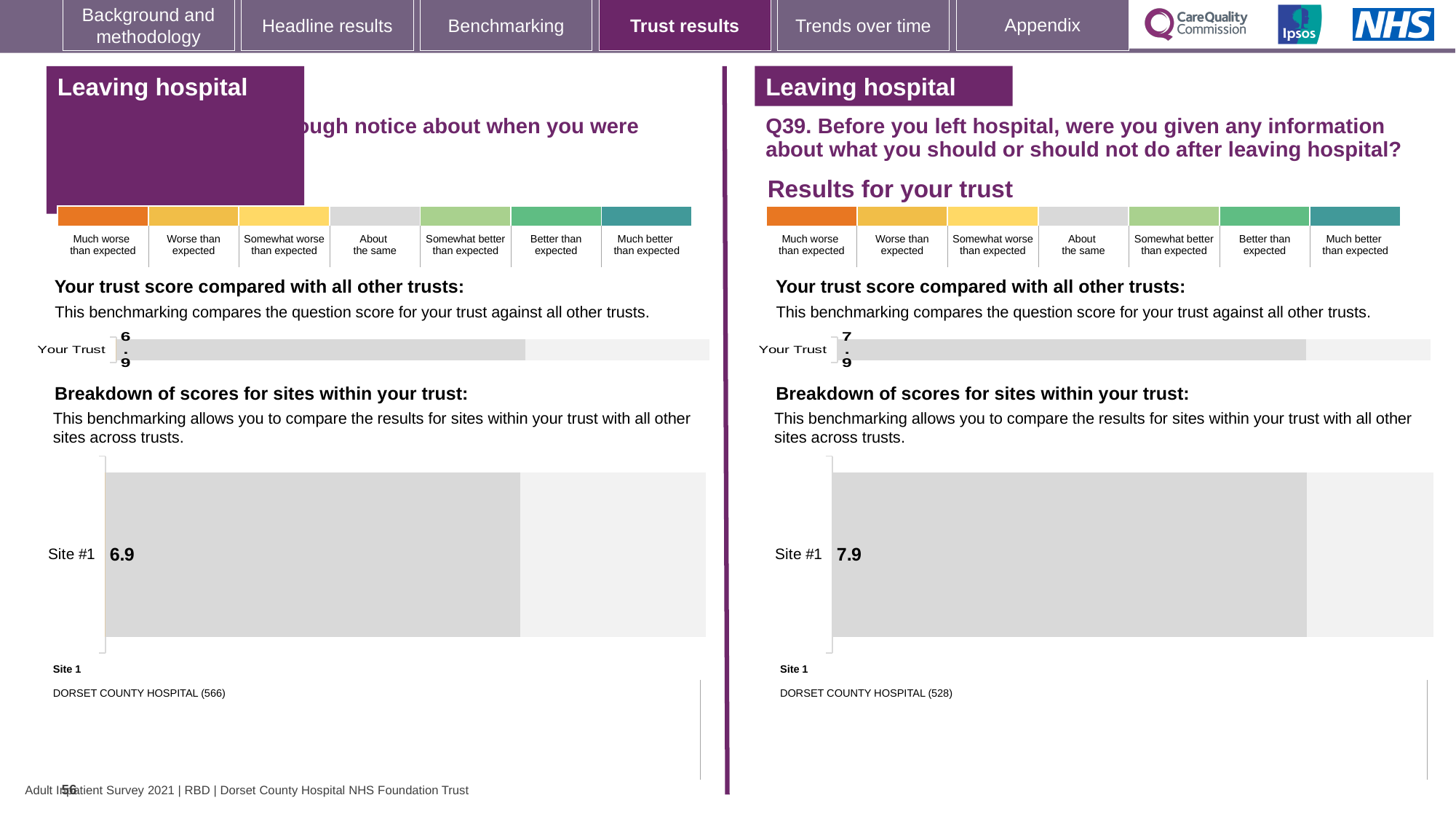
On the left-hand side of the slide, which site name is listed as Site 1 below the chart? DORSET COUNTY HOSPITAL (566) On the left-hand side of the slide, what is the score shown for Your Trust in the 'Your trust score compared with all other trusts' chart? 6.9 On the right-hand side of the slide (Q39), which site name is listed as Site 1 below the chart? DORSET COUNTY HOSPITAL (528) What type of chart is used to show the Site #1 score on the right-hand side of the slide (Q39)? bar chart On the left-hand side of the slide, what score is shown for Site #1 in the 'Breakdown of scores for sites within your trust' chart? 6.9 Which is larger: the Site #1 score on the left-hand side of the slide or the Site #1 score on the right-hand side (Q39)? Right-hand side (Q39) What is the difference between the Site #1 score on the right-hand side (Q39) and the Site #1 score on the left-hand side of the slide? 1.0 On the right-hand side of the slide (Q39), what is the score shown for Your Trust in the 'Your trust score compared with all other trusts' chart? 7.9 On the right-hand side of the slide (Q39), what score is shown for Site #1 in the 'Breakdown of scores for sites within your trust' chart? 7.9 How many sites are plotted in the 'Breakdown of scores for sites within your trust' chart on the left-hand side of the slide? 1 How many sites are plotted in the 'Breakdown of scores for sites within your trust' chart on the right-hand side of the slide (Q39)? 1